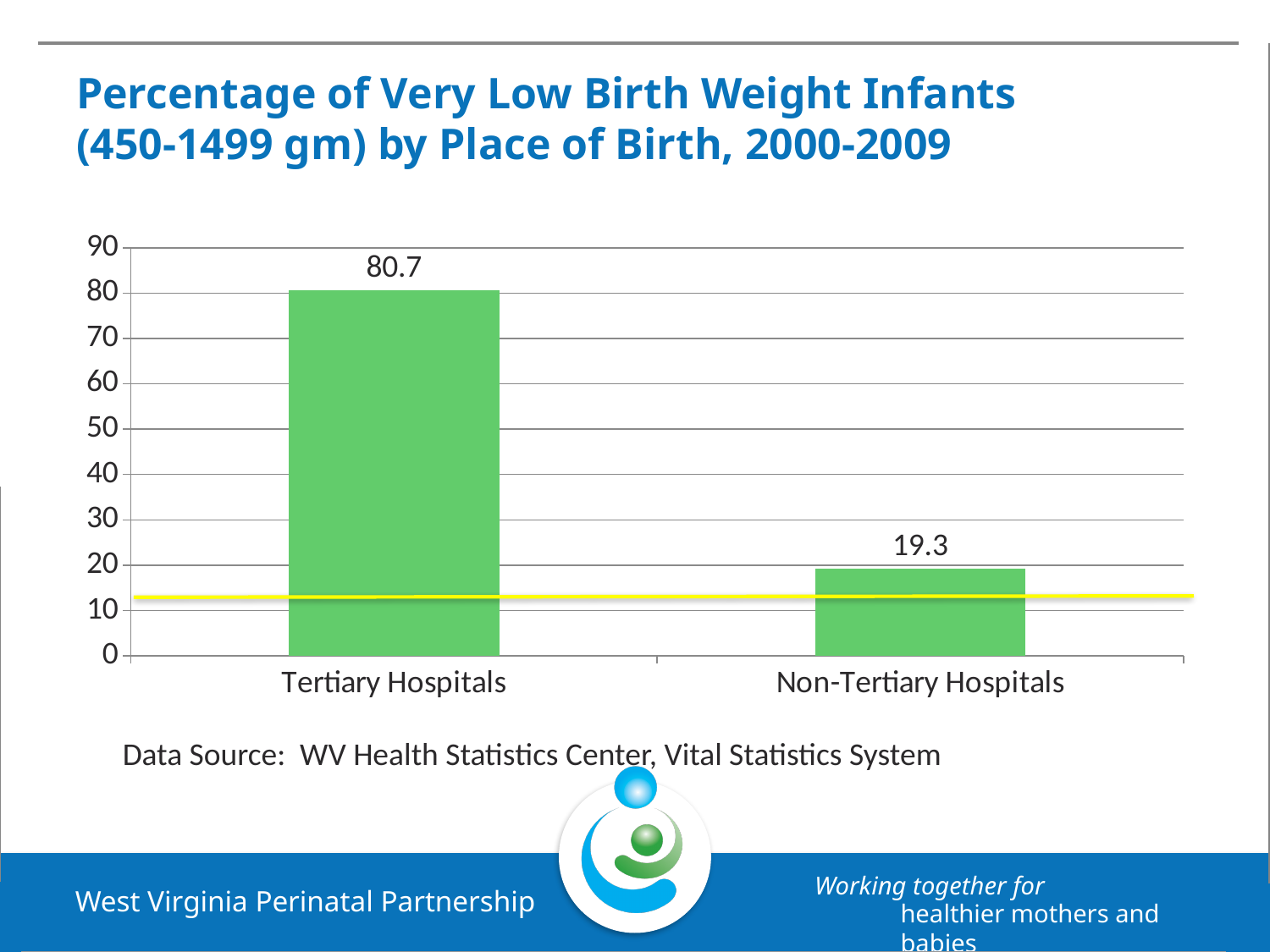
Which is larger, the value for Tertiary Hospitals or the value for Non-Tertiary Hospitals? Tertiary Hospitals What is the highest value shown on the y axis? 90 How many categories are shown on the x axis? 2 Is the value for Tertiary Hospitals greater or less than 80? greater Which category has the lowest value? Non-Tertiary Hospitals Is the value for Non-Tertiary Hospitals greater or less than 20? less What kind of chart is shown on the slide? bar chart Which category has the highest value? Tertiary Hospitals What is the title of the chart? Percentage of Very Low Birth Weight Infants (450-1499 gm) by Place of Birth, 2000-2009 What is the value for Tertiary Hospitals? 80.7 What is the difference between the values for Tertiary Hospitals and Non-Tertiary Hospitals? 61.4 What is the value for Non-Tertiary Hospitals? 19.3